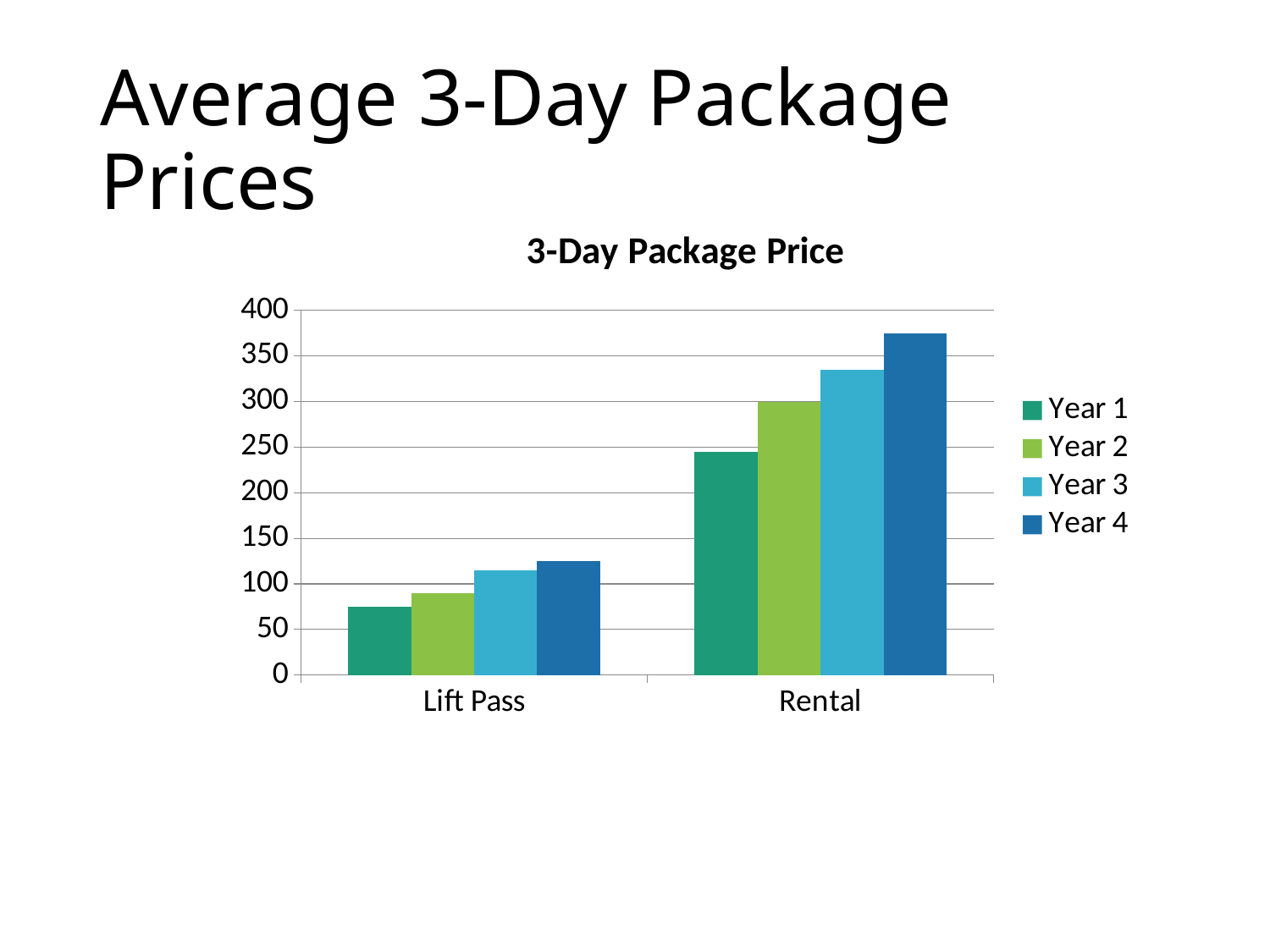
How many series does the legend list? 4 Which category has the highest bars, Lift Pass or Rental? Rental Is the Year 1 value for Lift Pass greater or less than 100? less Is the Year 4 value for Rental greater or less than 350? greater Which series has the highest value for Rental? Year 4 Is the Year 4 value for Lift Pass greater or less than 100? greater Do the values for Rental rise or fall from Year 1 to Year 4? rise How many categories are shown on the x axis? 2 Which series has the lowest value for Lift Pass? Year 1 What type of chart is shown on the slide? bar chart What is the title of the chart? 3-Day Package Price